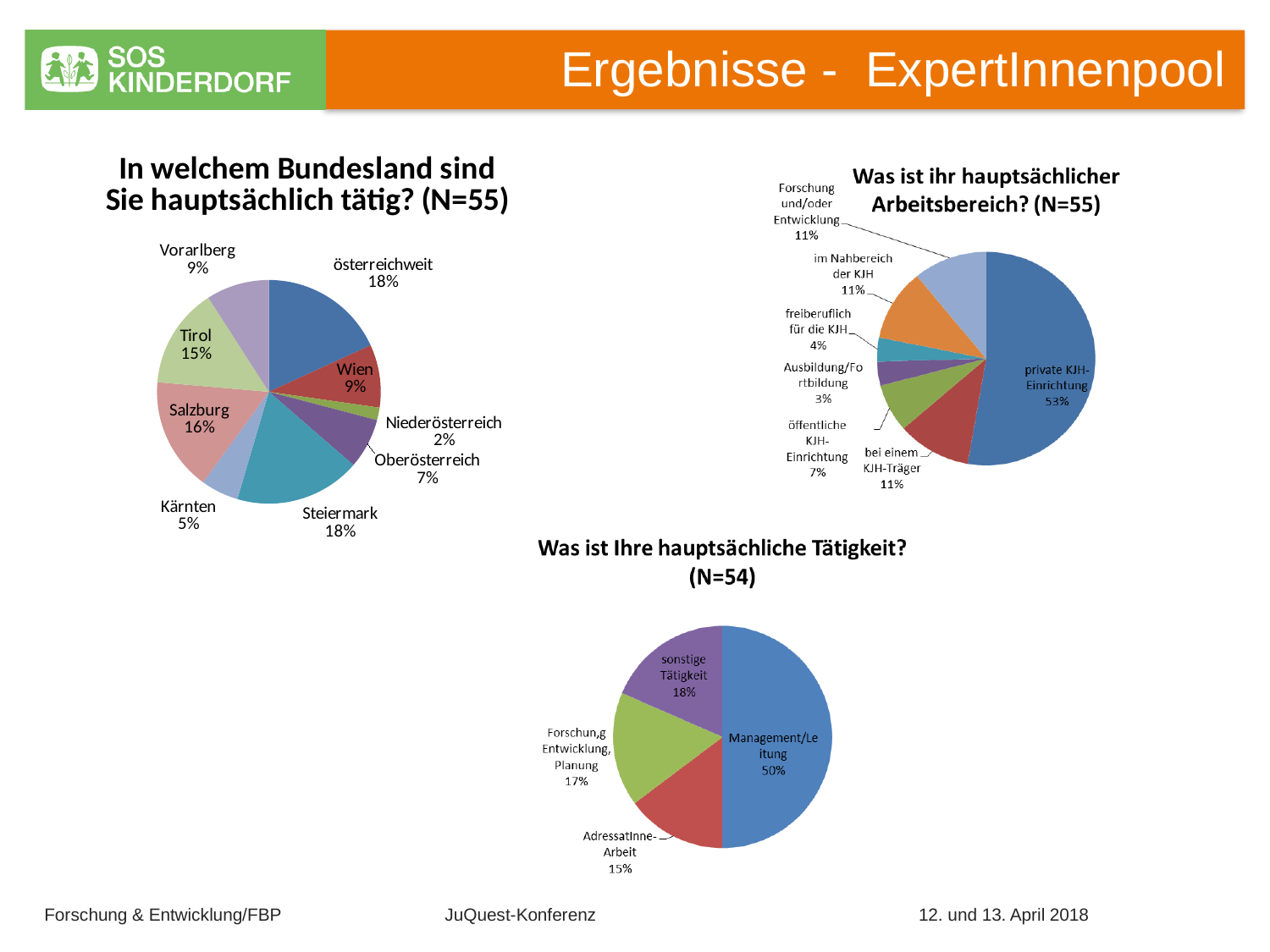
In the chart 'In welchem Bundesland sind Sie hauptsächlich tätig? (N=55)', which Bundesland has the smallest share? Niederösterreich In the chart 'Was ist ihr hauptsächlicher Arbeitsbereich? (N=55)', which category has the largest share? private KJH-Einrichtung In the chart 'Was ist ihr hauptsächlicher Arbeitsbereich? (N=55)', what share is shown for 'private KJH-Einrichtung'? 53% In the chart 'Was ist Ihre hauptsächliche Tätigkeit? (N=54)', what is the difference between the shares for 'sonstige Tätigkeit' and 'AdressatInnen-Arbeit'? 3% What type of chart is 'Was ist Ihre hauptsächliche Tätigkeit? (N=54)'? Pie chart In the chart 'In welchem Bundesland sind Sie hauptsächlich tätig? (N=55)', what is the difference between the shares for Tirol and Kärnten? 10% In the chart 'Was ist Ihre hauptsächliche Tätigkeit? (N=54)', what share is shown for 'Management/Leitung'? 50% In the chart 'In welchem Bundesland sind Sie hauptsächlich tätig? (N=55)', which is larger, the share for Oberösterreich or the share for Wien? Wien In the chart 'Was ist ihr hauptsächlicher Arbeitsbereich? (N=55)', how many categories are shown? 7 In the chart 'In welchem Bundesland sind Sie hauptsächlich tätig? (N=55)', how many categories are shown? 9 In the chart 'Was ist ihr hauptsächlicher Arbeitsbereich? (N=55)', which category has the smallest share? Ausbildung/Fortbildung In the chart 'In welchem Bundesland sind Sie hauptsächlich tätig? (N=55)', what share is shown for Salzburg? 16%